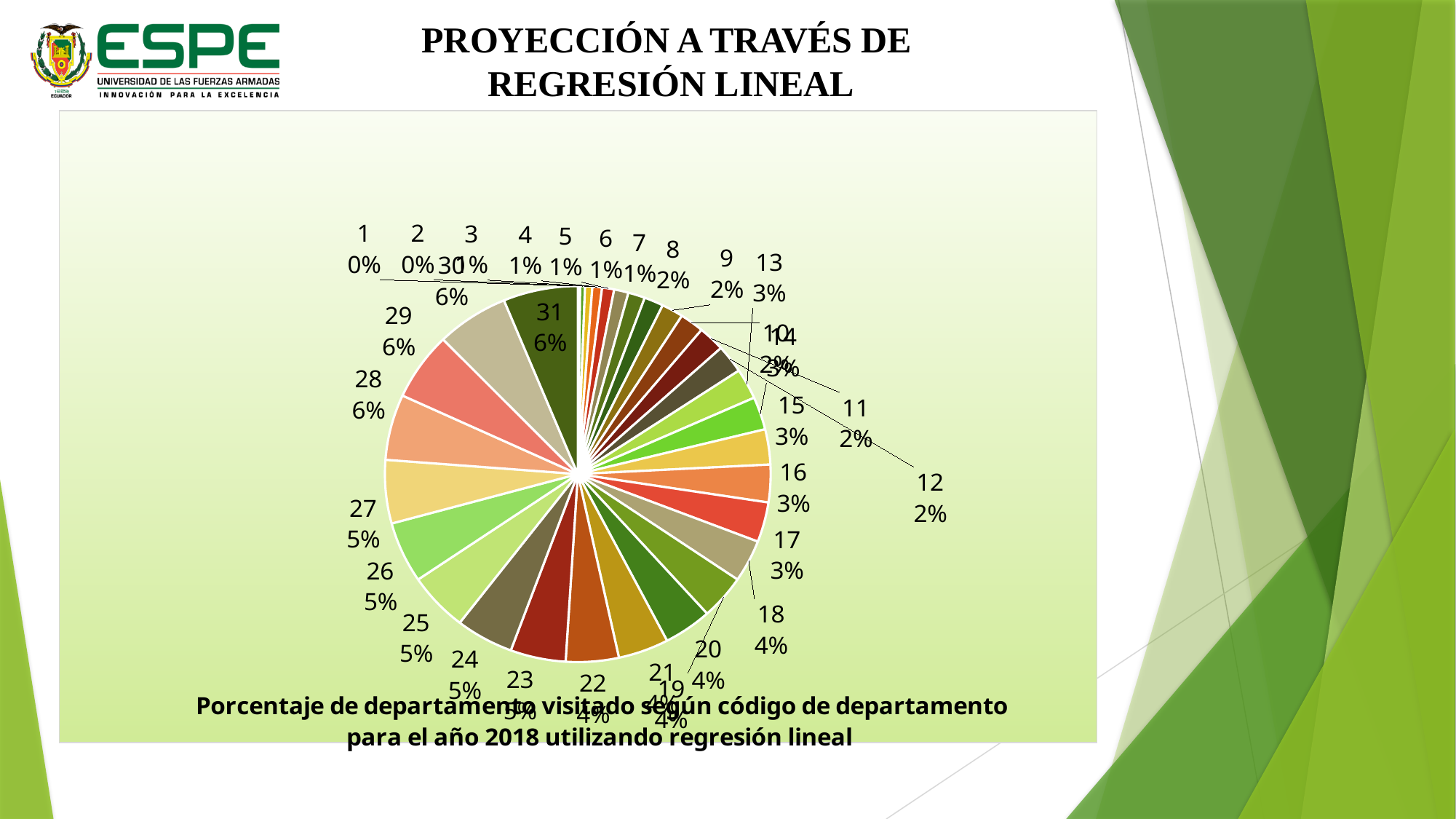
What percentage is shown for department code 17? 3% What share of the pie does department code 31 represent? 6% What percentage is shown for department code 8? 2% What is the difference in percentage points between department code 28 and department code 9? 4 What percentage is shown for department code 18? 4% Which has the larger share, department code 5 or department code 27? 27 What percentage is shown for department code 25? 5% What kind of chart is shown on the slide? pie chart What is the caption/title written below the pie chart? Porcentaje de departamento visitado según código de departamento para el año 2018 utilizando regresión lineal How many slices (department codes) does the pie chart have? 31 What percentage is shown for department code 1? 0% Which has the larger share, department code 31 or department code 8? 31